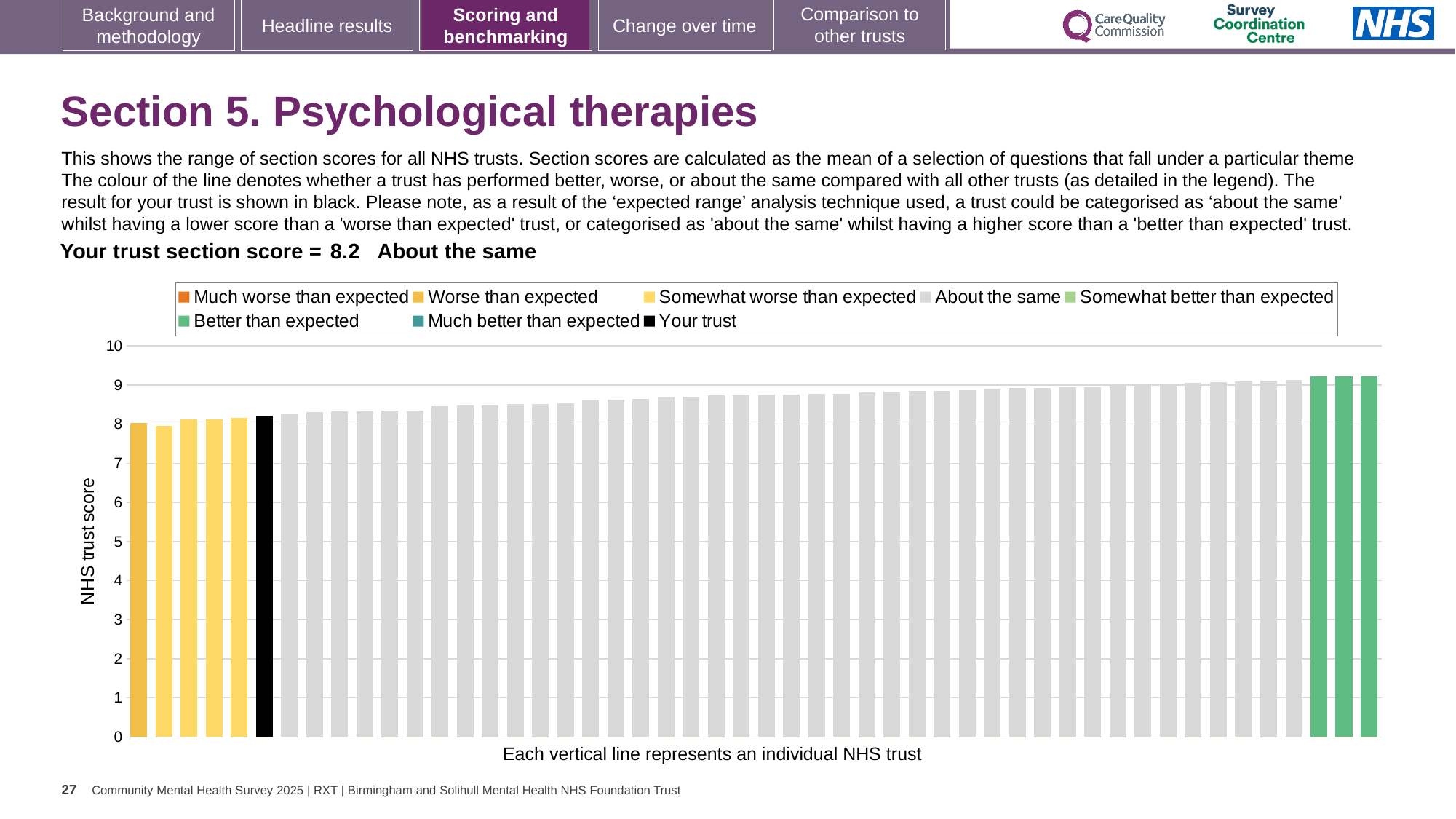
What is the section score for your trust shown on the slide? 8.2 How many entries does the chart legend list? 8 How many bars are coloured green (Better than expected)? 3 How many bars are coloured yellow (worse than expected categories)? 5 Is the value of the highest bar greater or less than 9? greater Do the bar values rise or fall from left to right along the x axis? rise Which category is your trust placed in for this section? About the same What kind of chart is shown on the slide? bar chart Is the value of the lowest bar greater or less than 7? greater What is the label on the vertical axis of the chart? NHS trust score What colour is the bar representing your trust? black